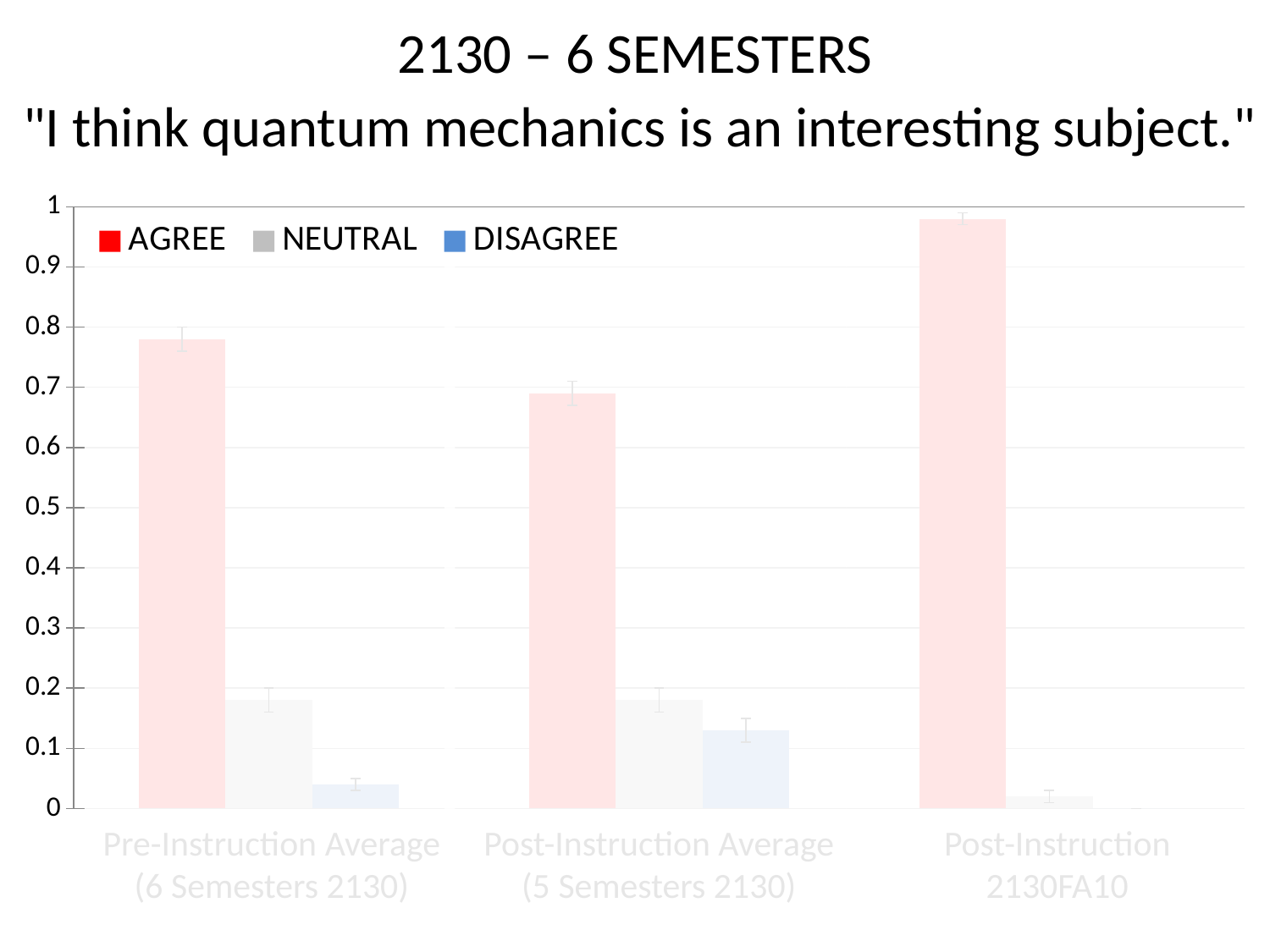
Which category has the highest AGREE value? Post-Instruction 2130FA10 How many series does the legend list? 3 Is the AGREE value for Post-Instruction 2130FA10 greater or less than 0.9? greater What survey statement is quoted in the slide title? "I think quantum mechanics is an interesting subject." Which category has the lowest NEUTRAL value? Post-Instruction 2130FA10 Is the AGREE value for Post-Instruction Average (5 Semesters 2130) greater or less than 0.8? less Which is larger, the DISAGREE value for Pre-Instruction Average (6 Semesters 2130) or the DISAGREE value for Post-Instruction Average (5 Semesters 2130)? Post-Instruction Average (5 Semesters 2130) Is the DISAGREE value for Post-Instruction Average (5 Semesters 2130) greater or less than 0.2? less What kind of chart is shown on the slide? bar chart How many categories are shown along the x axis? 3 Which category has the lowest AGREE value? Post-Instruction Average (5 Semesters 2130)